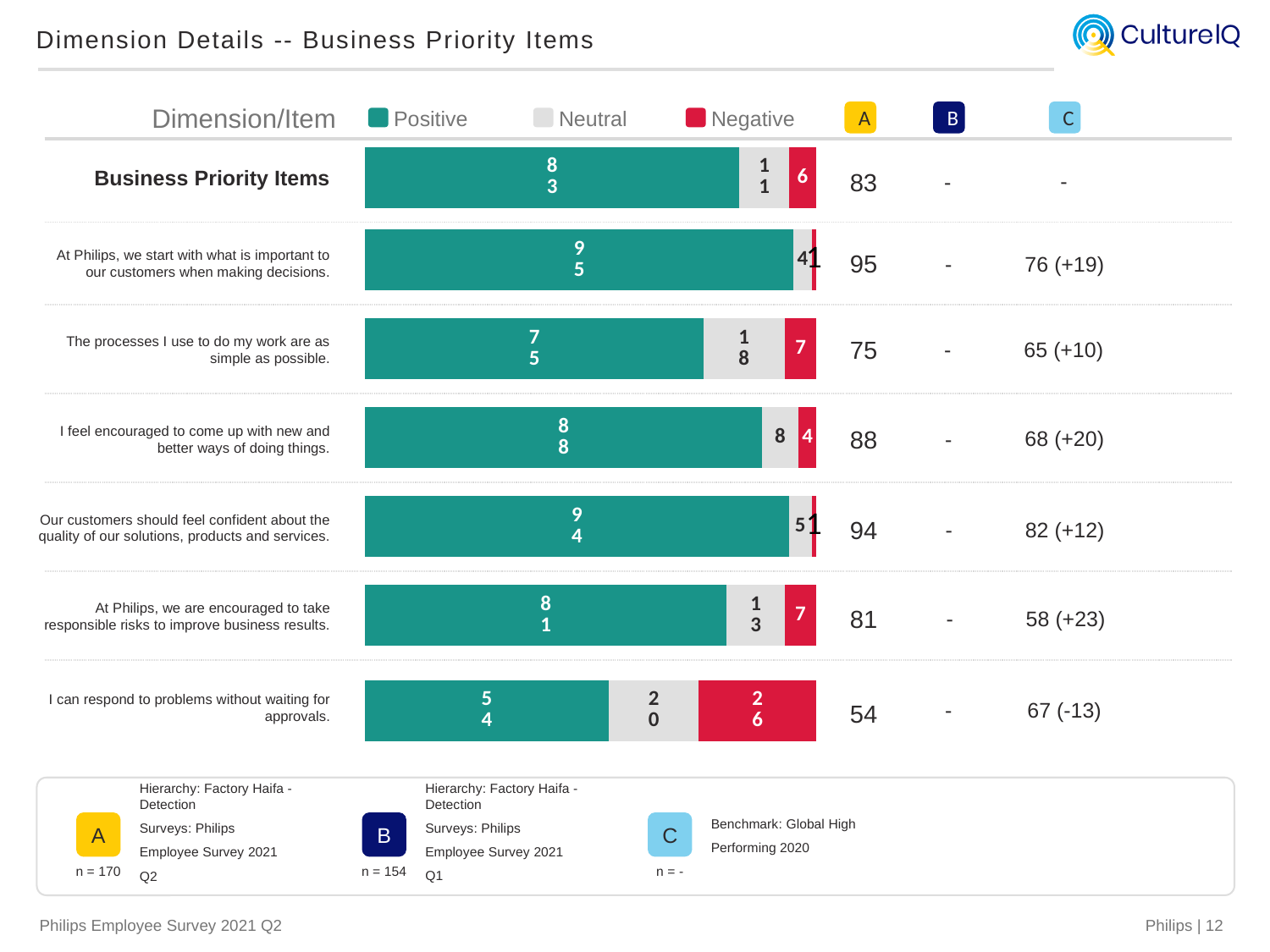
What is the Positive value for "I can respond to problems without waiting for approvals."? 54 What kind of chart is used to show the Positive, Neutral and Negative responses? stacked bar chart What colour represents the Negative series in the legend? red Which has a larger Negative value: "The processes I use to do my work are as simple as possible." or "I feel encouraged to come up with new and better ways of doing things."? The processes I use to do my work are as simple as possible. What is the Neutral value for "The processes I use to do my work are as simple as possible."? 18 How many series does the legend list? 3 Which item has the highest Positive value? At Philips, we start with what is important to our customers when making decisions. Which item has the lowest Positive value? I can respond to problems without waiting for approvals. What is the total of the Positive, Neutral and Negative values for the "Business Priority Items" bar? 100 What is the Negative value for "I can respond to problems without waiting for approvals."? 26 What is the difference between the Positive values for "I feel encouraged to come up with new and better ways of doing things." and "At Philips, we are encouraged to take responsible risks to improve business results."? 7 How many item bars are plotted in the chart, including the overall "Business Priority Items" bar? 7